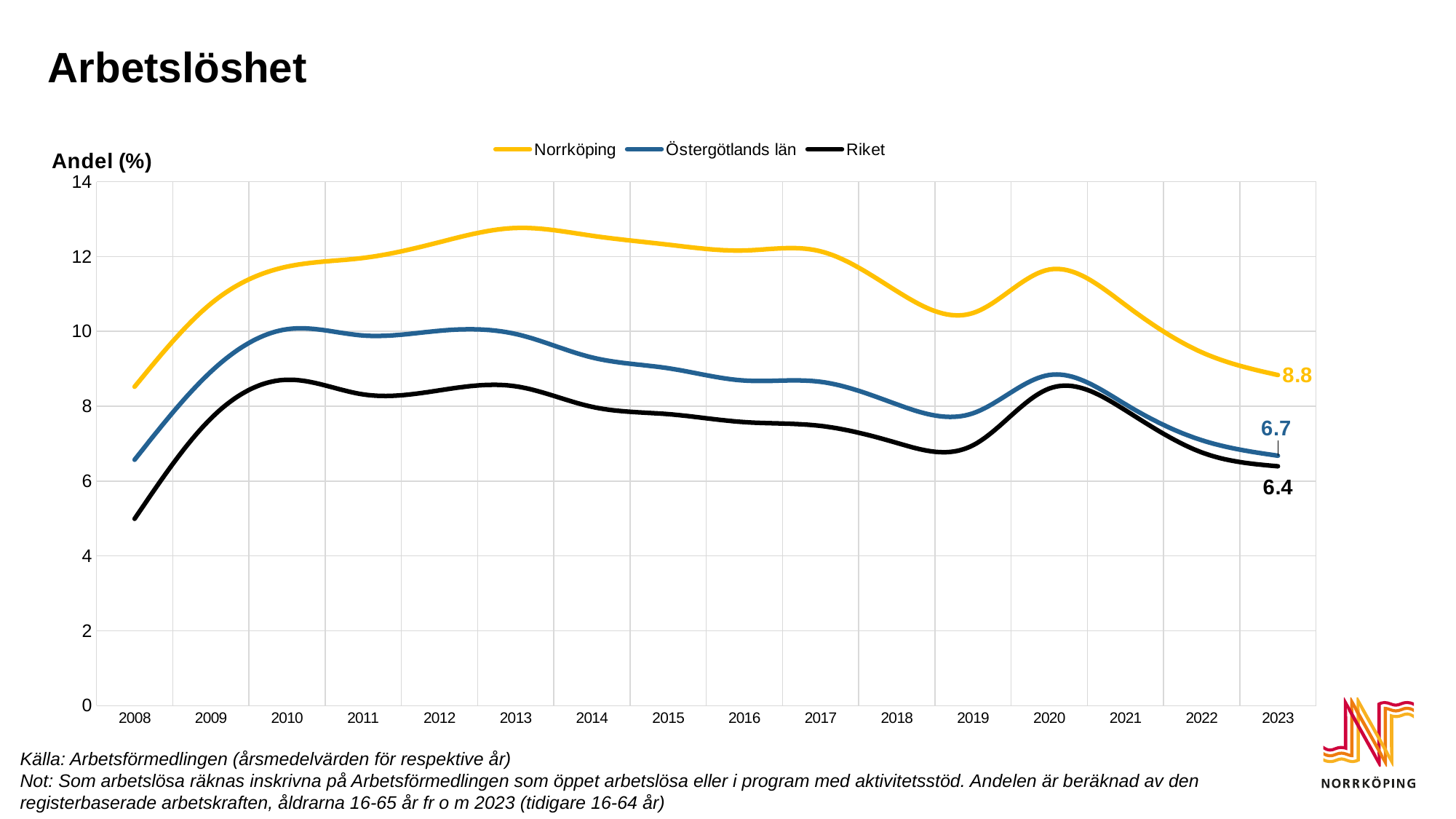
Is the value for Riket in 2008 greater or less than 6? less What is the value for Riket in 2023? 6.4 Which series has the highest value in 2023? Norrköping Is the value for Norrköping in 2013 greater or less than 12? greater How many years are shown on the x axis? 16 What is the value for Norrköping in 2023? 8.8 What is the difference between the Norrköping and Riket values in 2023? 2.4 What is the difference between the Östergötlands län and Riket values in 2023? 0.3 What is the value for Östergötlands län in 2023? 6.7 What kind of chart is shown on the slide? Line chart How many series does the legend list? 3 Which series has the lowest value in 2023? Riket